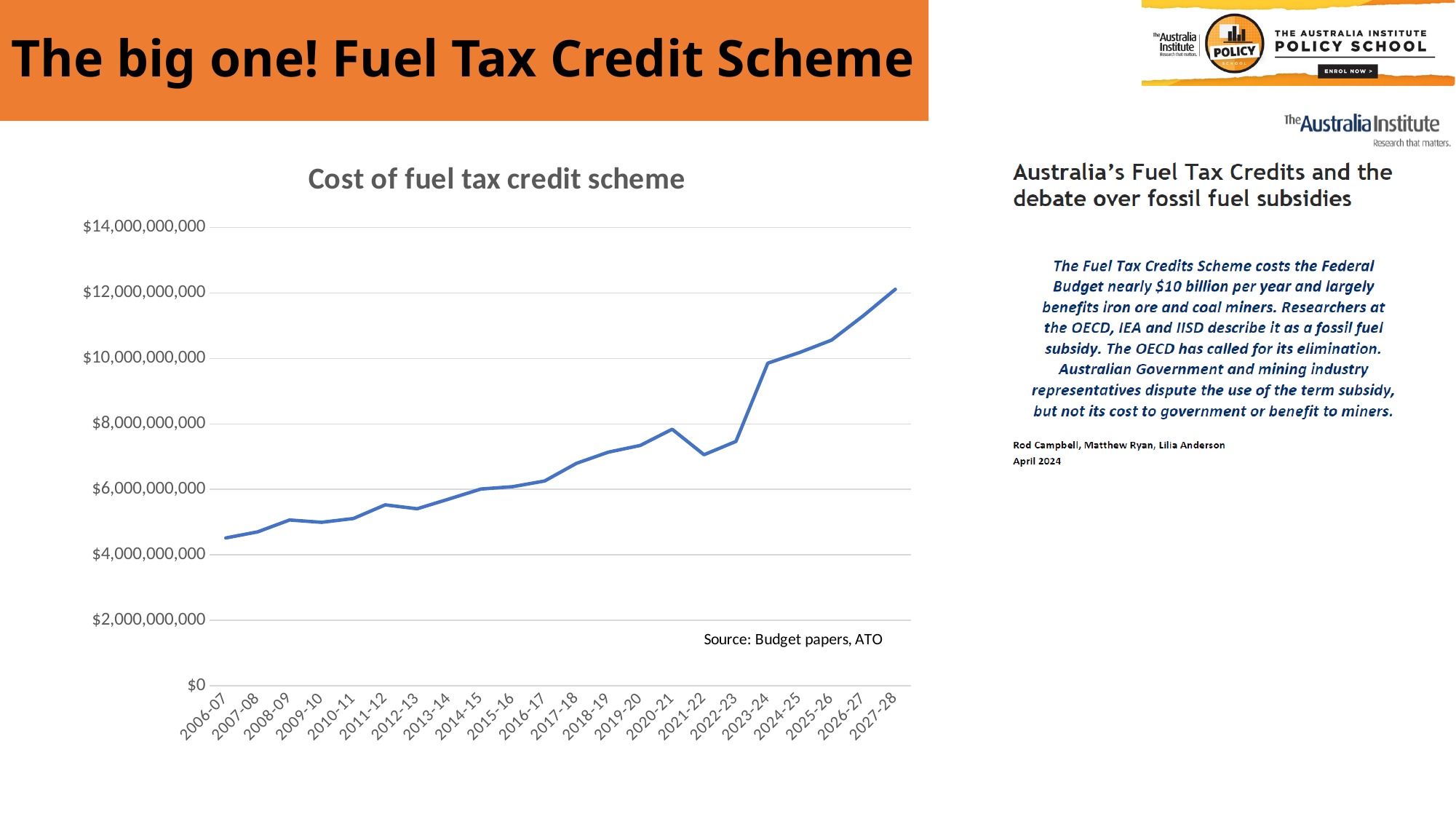
Which year has the larger value, 2020-21 or 2021-22? 2020-21 Is the value for 2021-22 greater or less than $8,000,000,000? less Which year has the highest cost of the fuel tax credit scheme? 2027-28 What kind of chart is shown on the slide? line chart Overall, does the cost of the fuel tax credit scheme rise or fall from 2006-07 to 2027-28? rise Is the value for 2006-07 greater or less than $6,000,000,000? less Which year has the lowest cost of the fuel tax credit scheme? 2006-07 Is the value for 2017-18 greater or less than $6,000,000,000? greater What source is cited for the chart's data? Budget papers, ATO How many financial years are plotted along the x axis of the chart? 22 What is the title of the chart? Cost of fuel tax credit scheme